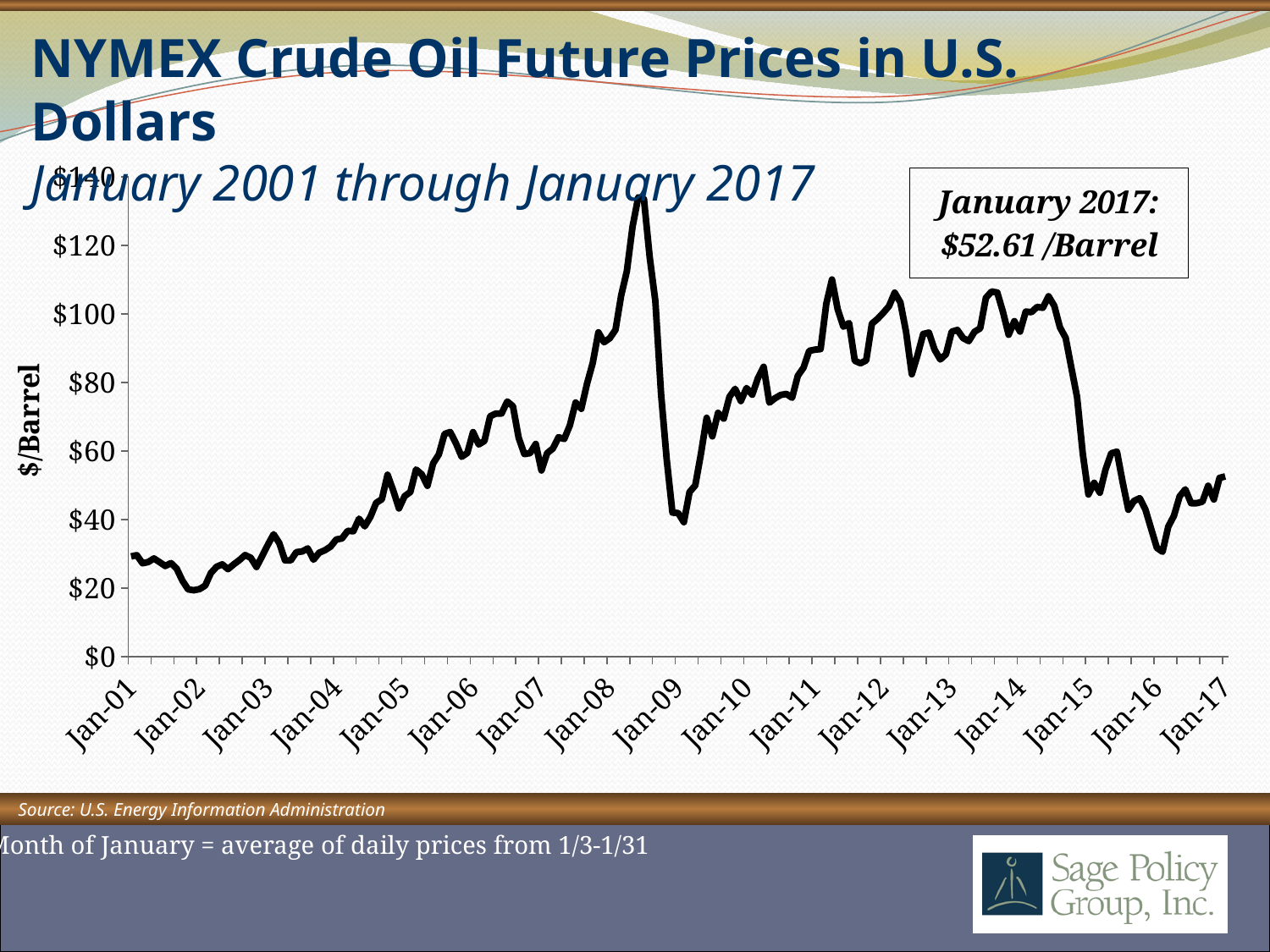
In which year does the line reach its highest point? 2008 Between Jan-14 and Jan-16, does the line rise or fall? fall Which is larger, the value at Jan-08 or the value at Jan-16? Jan-08 Is the value at Jan-09 greater or less than $60? less How many year labels are shown on the x axis? 17 What source is cited for the chart? U.S. Energy Information Administration What is the label on the y axis? $/Barrel What is the price per barrel for January 2017 according to the callout box? $52.61 Is the value at Jan-02 greater or less than $40? less Is the value at Jan-16 greater or less than $40? less What kind of chart is shown on the slide? line chart